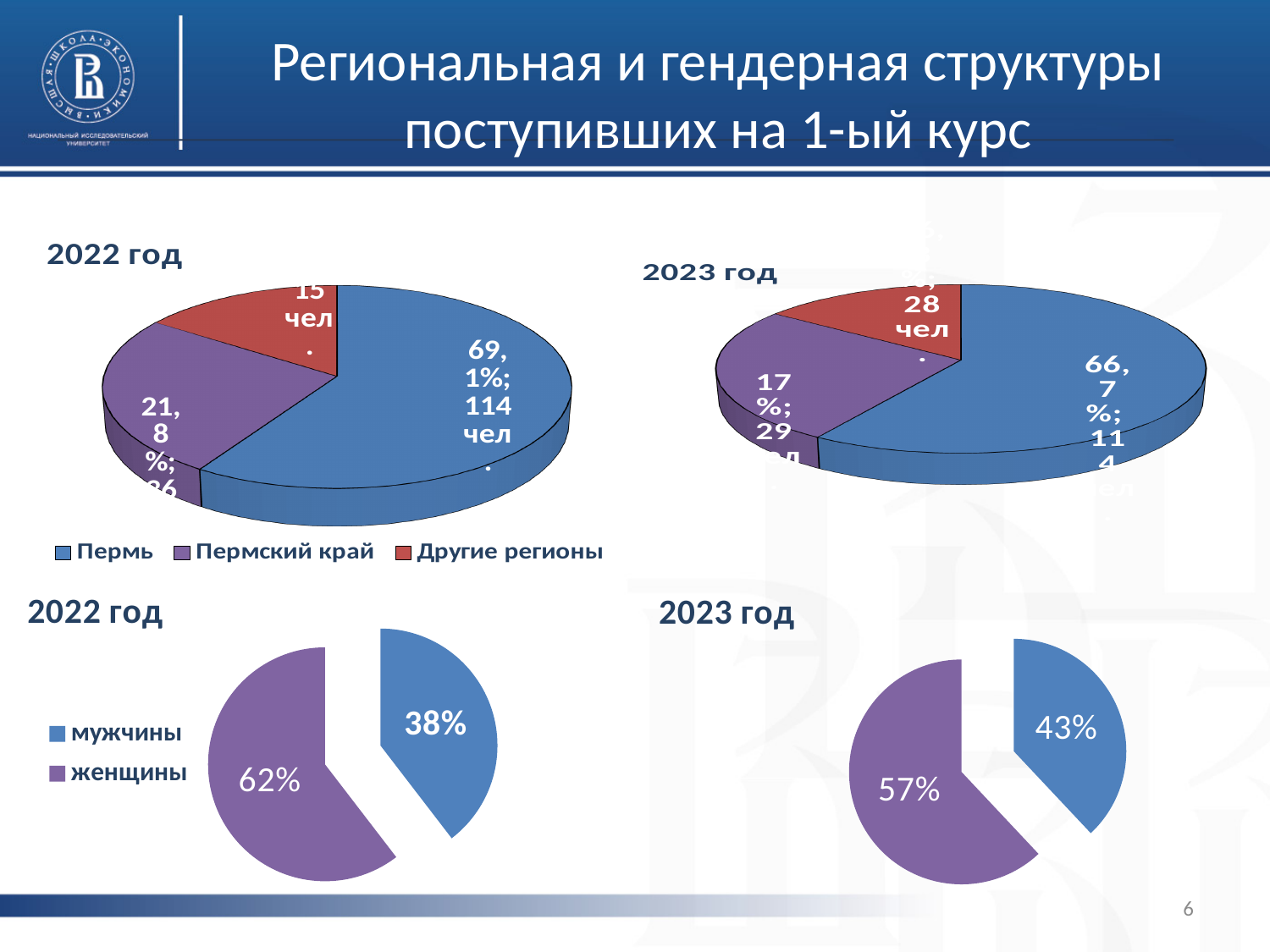
In the 2022 gender pie chart (bottom left), what share is мужчины? 38% In the 2023 gender pie chart (bottom right), what is the difference between the женщины share and the мужчины share? 14% How many categories does the legend of the regional pie charts (top row) list? 3 In the 2023 regional pie chart (top right), how many admitted students came from Другие регионы? 28 чел. What type of chart is used for the 2022 gender structure (bottom left)? Pie chart In the 2022 regional pie chart (top left), what share of admitted students came from Пермь? 69,1% In the 2023 regional pie chart (top right), what share of admitted students came from Пермский край? 17% In the 2022 regional pie chart (top left), how many admitted students came from Пермь? 114 чел. In the 2022 regional pie chart (top left), which region has the largest slice? Пермь In the 2022 regional pie chart (top left), how many admitted students came from Другие регионы? 15 чел. In the 2023 regional pie chart (top right), what share of admitted students came from Пермь? 66,7% In the 2023 gender pie chart (bottom right), what share is женщины? 57%